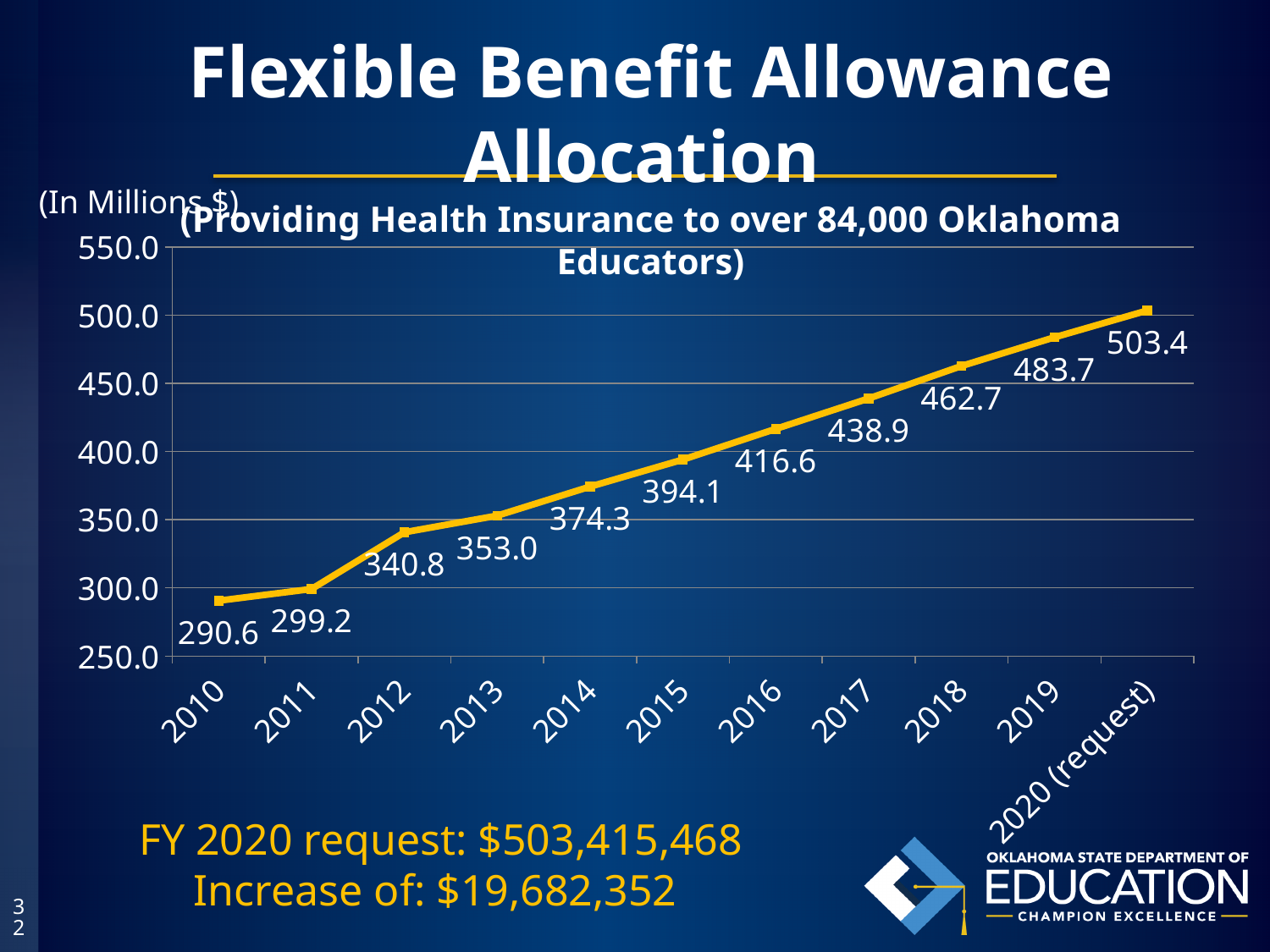
Which year has the lowest value on the chart? 2010 What is the value plotted for 2020 (request)? 503.4 What is the value plotted for 2015? 394.1 What is the difference between the 2012 value and the 2011 value? 41.6 Is the value for 2018 greater or less than 450.0? greater How many years are plotted on the x axis? 11 Which is larger, the value for 2016 or the value for 2017? 2017 Which year has the highest value on the chart? 2020 (request) What kind of chart is shown on the slide? line chart What is the difference between the 2020 (request) value and the 2019 value? 19.7 What is the Flexible Benefit Allowance value for 2010? 290.6 Do the values rise or fall from 2010 to 2020 (request)? rise